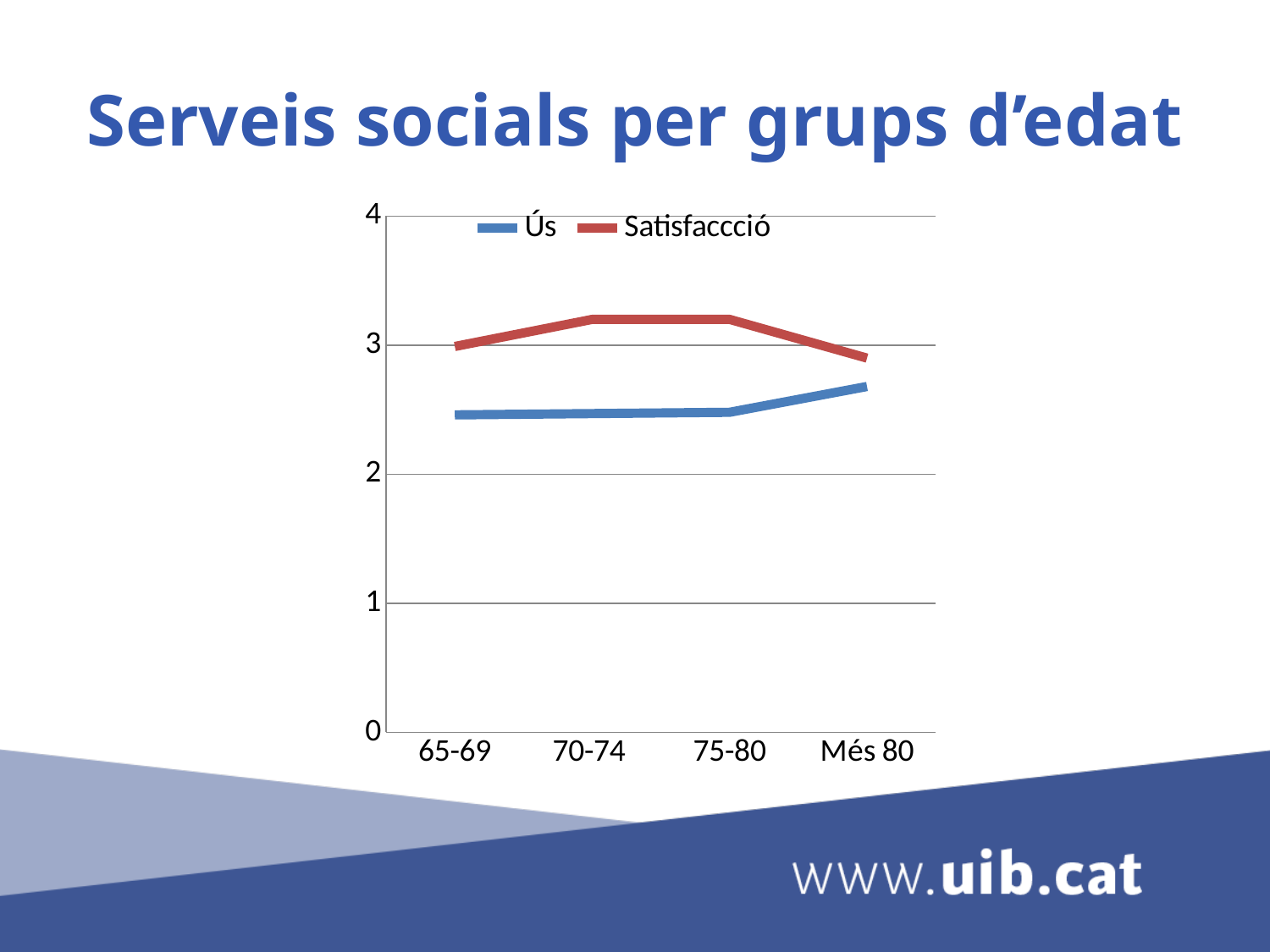
Is the value of Ús for 65-69 greater or less than 2? greater What is the title of the chart? Serveis socials per grups d'edat Is the value of Ús for Més 80 greater or less than 3? less Which series is drawn in red? Satisfaccció Does the Satisfacció series rise or fall from 75-80 to Més 80? fall What type of chart is shown on the slide? line chart Is the value of Satisfacció for 70-74 greater or less than 3? greater For the 70-74 group, which series has the higher value, Ús or Satisfacció? Satisfacció How many age groups are shown on the x axis? 4 How many series does the legend list? 2 Does the Ús series rise or fall from 75-80 to Més 80? rise For which age group is the Ús series highest? Més 80